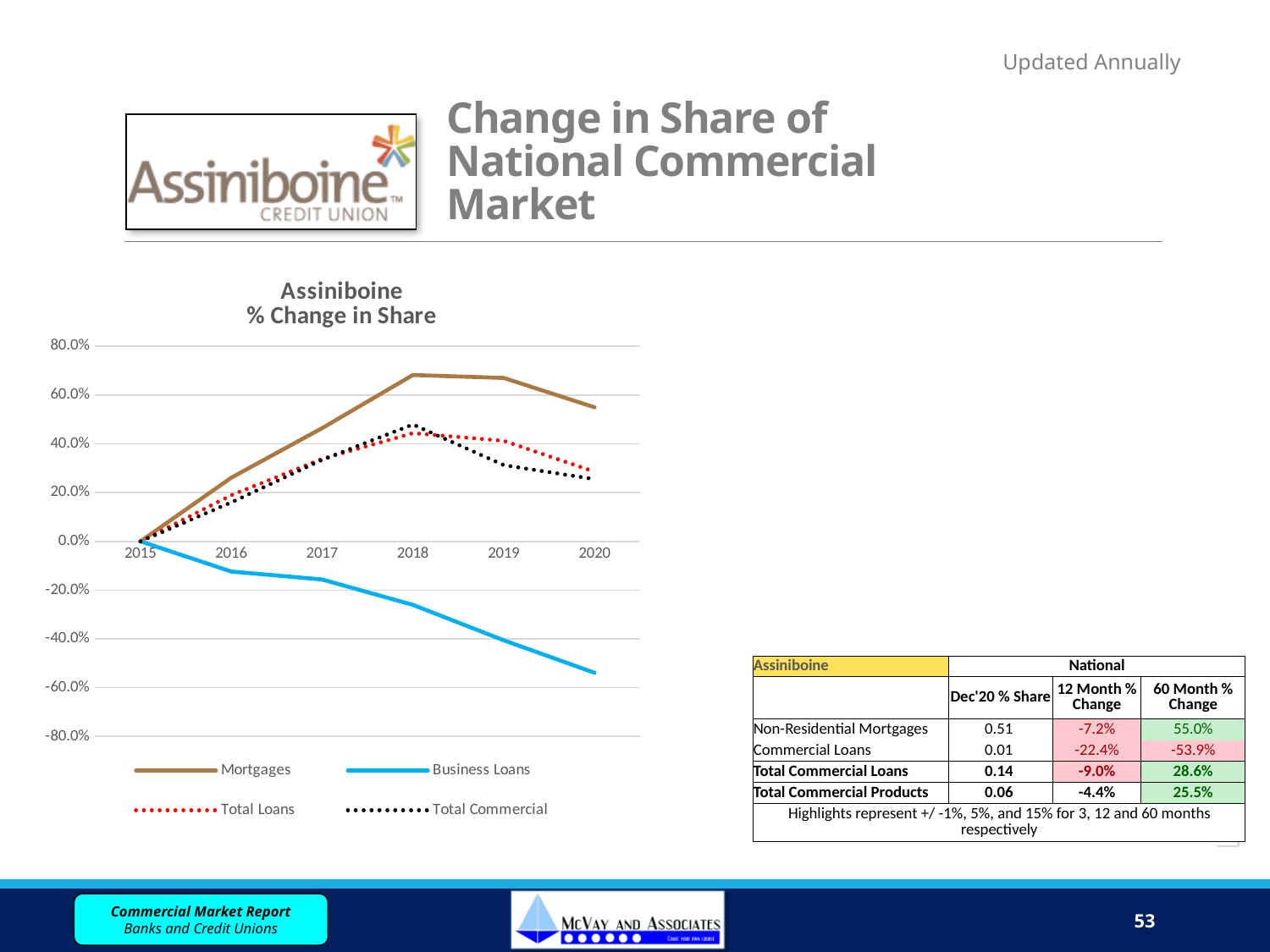
How many series does the chart legend list? 4 Is the value for Mortgages in 2018 greater or less than 60.0%? greater Which series has the lowest value in 2020? Business Loans Which series has the highest value in 2020? Mortgages Is the value for Total Commercial in 2018 greater or less than 40.0%? greater What is the title of the chart? Assiniboine % Change in Share Does the Business Loans series rise or fall from 2015 to 2020? fall In 2019, which is larger: the value for Mortgages or the value for Business Loans? Mortgages Is the value for Business Loans in 2020 greater or less than -40.0%? less Which series is drawn as a solid blue line in the chart? Business Loans What kind of chart is shown on the slide? line chart How many years are shown along the x axis of the chart? 6